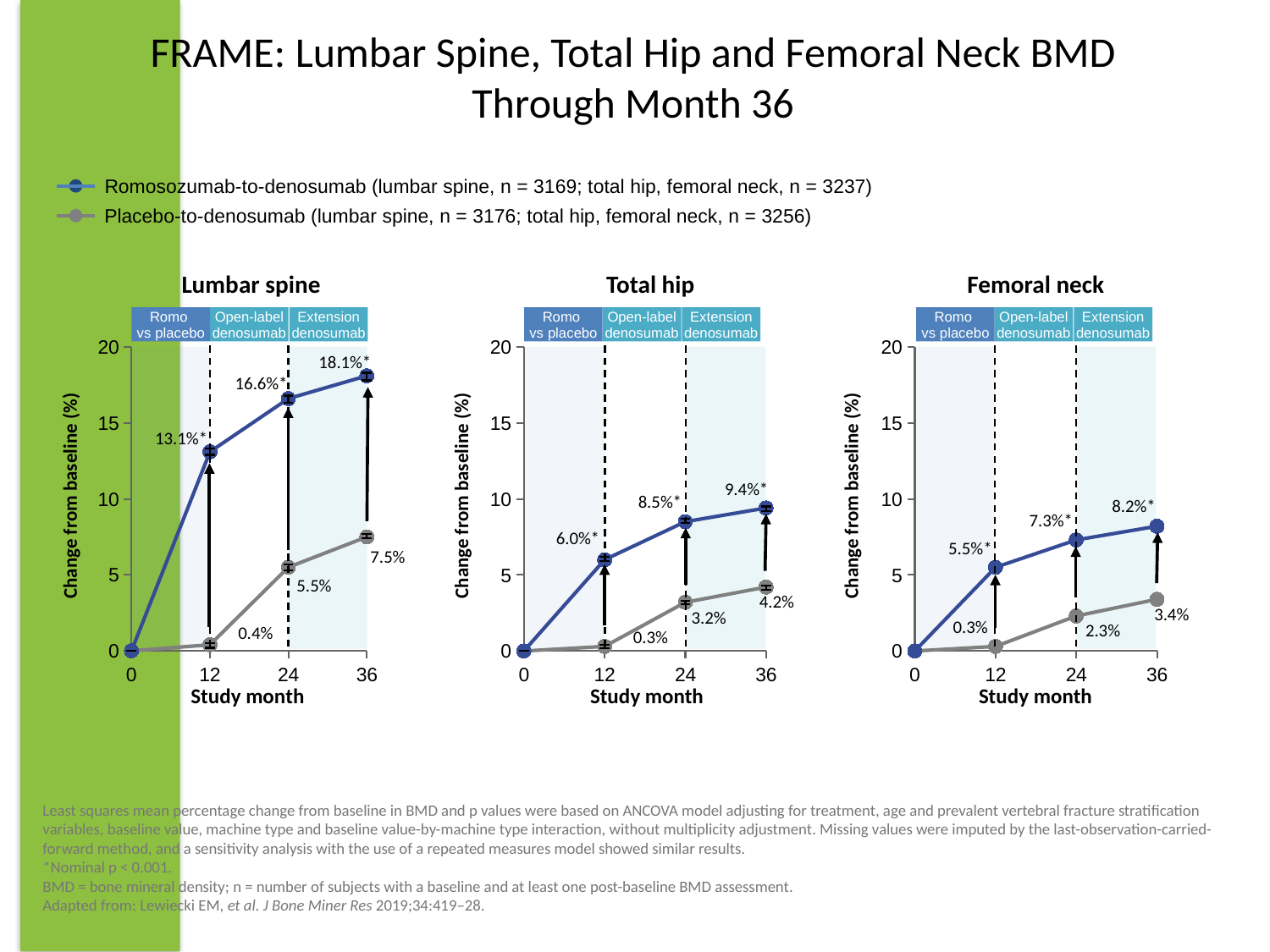
In the Lumbar spine chart, what is the difference between the two groups at month 36? 10.6 percentage points What kind of chart is the Total hip chart? Line chart In the Femoral neck chart, which group has the higher change from baseline at month 24? Romosozumab-to-denosumab In the Total hip chart, what is the difference between the romosozumab-to-denosumab and placebo-to-denosumab values at month 36? 5.2 percentage points In the Femoral neck chart, what is the change from baseline for the placebo-to-denosumab group at month 36? 3.4% In the Total hip chart, what is the change from baseline for the romosozumab-to-denosumab group at month 12? 6.0% How many series does the legend list? 2 In the Lumbar spine chart, what is the change from baseline for the romosozumab-to-denosumab group at month 36? 18.1% In the Lumbar spine chart, what is the change from baseline for the placebo-to-denosumab group at month 24? 5.5% What is the y-axis label on the Lumbar spine chart? Change from baseline (%) In the Lumbar spine chart, is the romosozumab-to-denosumab value at month 24 greater or less than 15? greater In the Femoral neck chart, does the romosozumab-to-denosumab line rise or fall from month 0 to month 36? Rise